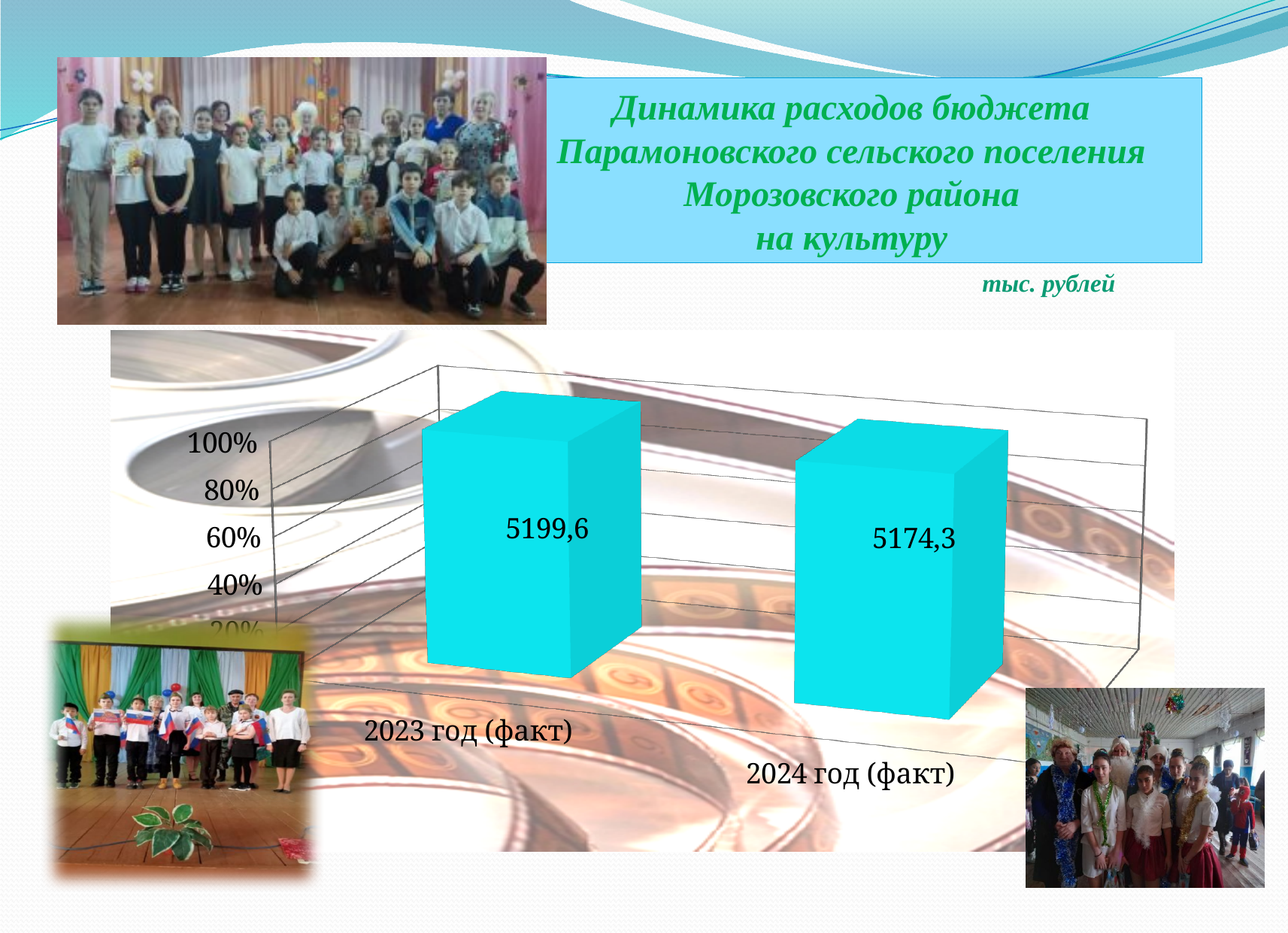
What is the title of the chart? Динамика расходов бюджета Парамоновского сельского поселения Морозовского района на культуру In what units are the chart values given? тыс. рублей Do the values rise or fall from 2023 год (факт) to 2024 год (факт)? fall What is the value for 2024 год (факт)? 5174,3 Which category has the highest value? 2023 год (факт) What is the value for 2023 год (факт)? 5199,6 Which year has the higher value, 2023 год (факт) or 2024 год (факт)? 2023 год (факт) What kind of chart is shown on the slide? bar chart How many categories are shown on the chart? 2 What is the difference between the values for 2023 год (факт) and 2024 год (факт)? 25,3 Which category has the lowest value? 2024 год (факт)